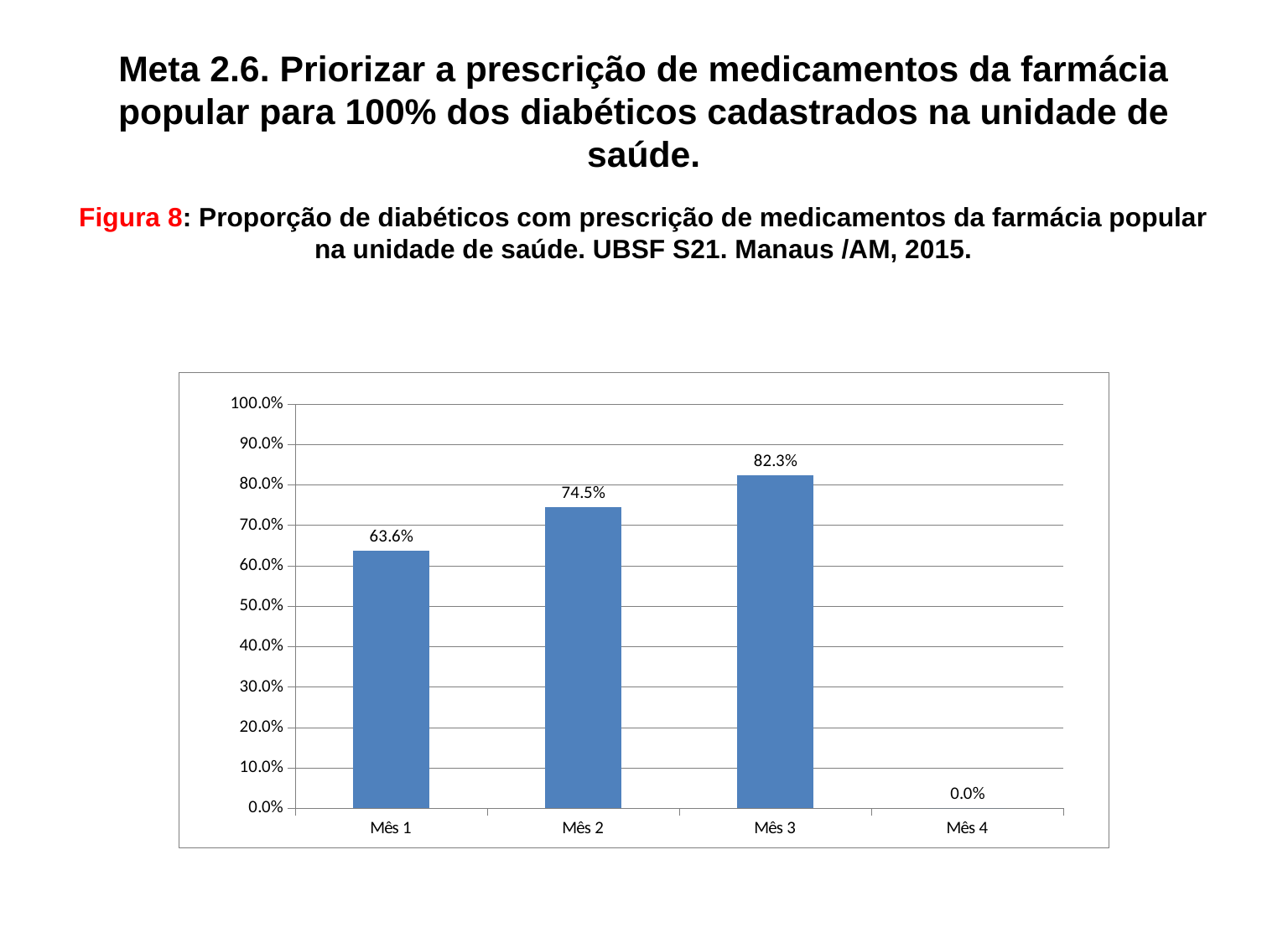
What is the value for Mês 4? 0.0% What is the difference between the values for Mês 3 and Mês 1? 18.7% What is the value for Mês 3? 82.3% Do the values rise or fall from Mês 1 to Mês 3? Rise What is the value for Mês 2? 74.5% How many months are shown on the x axis? 4 What is the value for Mês 1? 63.6% Which month has the highest value? Mês 3 What is the difference between the values for Mês 2 and Mês 1? 10.9% Which month has the lowest value? Mês 4 Which is larger, the value for Mês 2 or the value for Mês 3? Mês 3 What kind of chart is shown on the slide? Bar chart